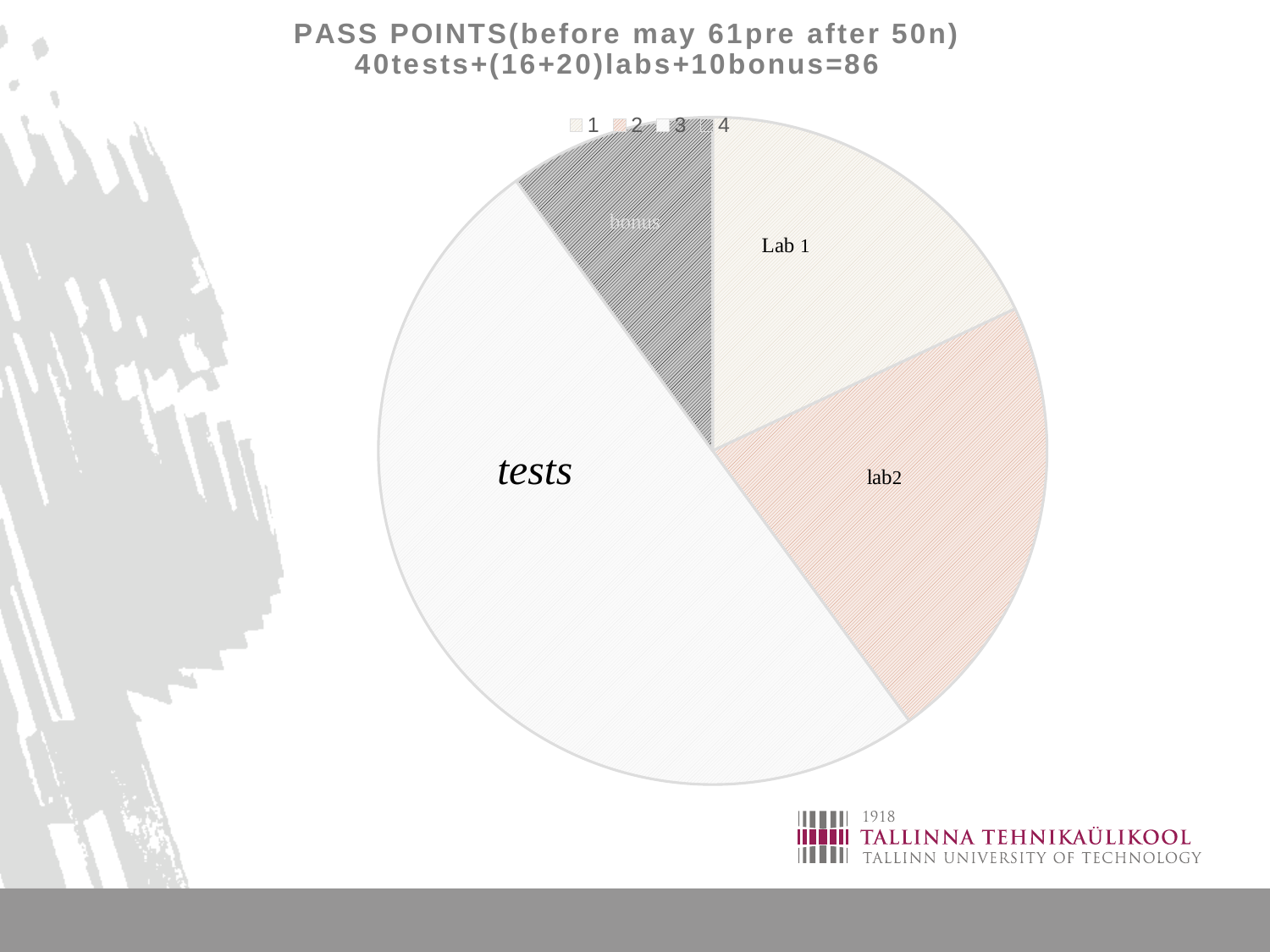
Which slice is larger in the pie chart, Lab 1 or bonus? Lab 1 How many entries does the legend of the pie chart list? 4 Which slice is larger in the pie chart, lab2 or Lab 1? lab2 Which slice is smaller in the pie chart, bonus or lab2? bonus What are the labels of the four slices in the pie chart? Lab 1, lab2, tests, bonus Which slice of the pie chart is the largest? tests Which slice of the pie chart is the smallest? bonus What total is given at the end of the chart title's formula? 86 How many slices does the pie chart have? 4 What kind of chart is shown on the slide? pie chart